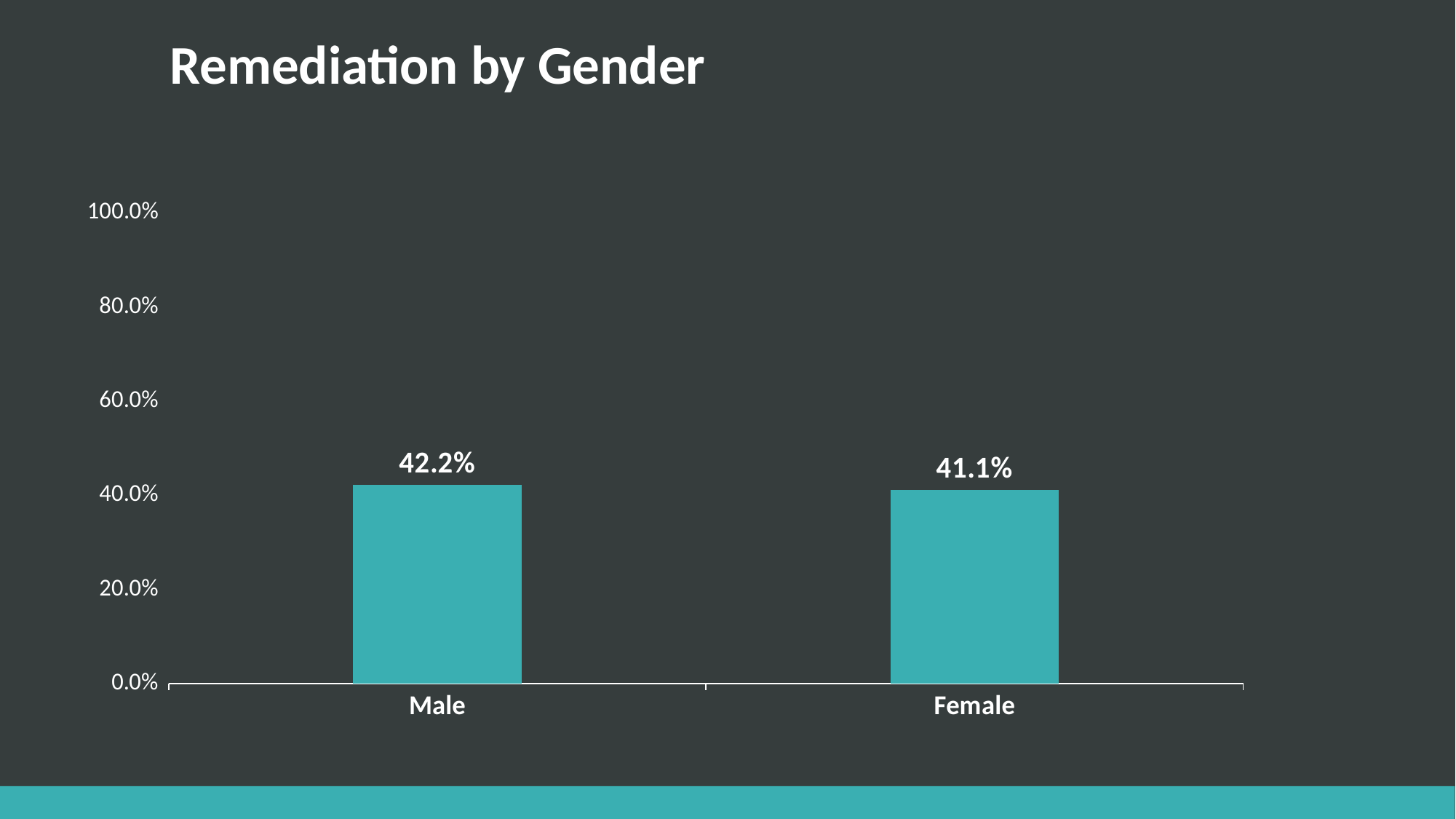
Which category has the highest value? Male What is the highest value shown on the y axis? 100.0% How many categories are shown on the x axis? 2 Is the value for Female greater or less than 60.0%? less What is the value for Male? 42.2% Which category has the lowest value? Female Is the value for Male greater or less than 40.0%? greater What is the title of the chart? Remediation by Gender What kind of chart is shown on the slide? bar chart What is the value for Female? 41.1% What is the difference between the values for Male and Female? 1.1% Which is larger, the value for Male or the value for Female? Male